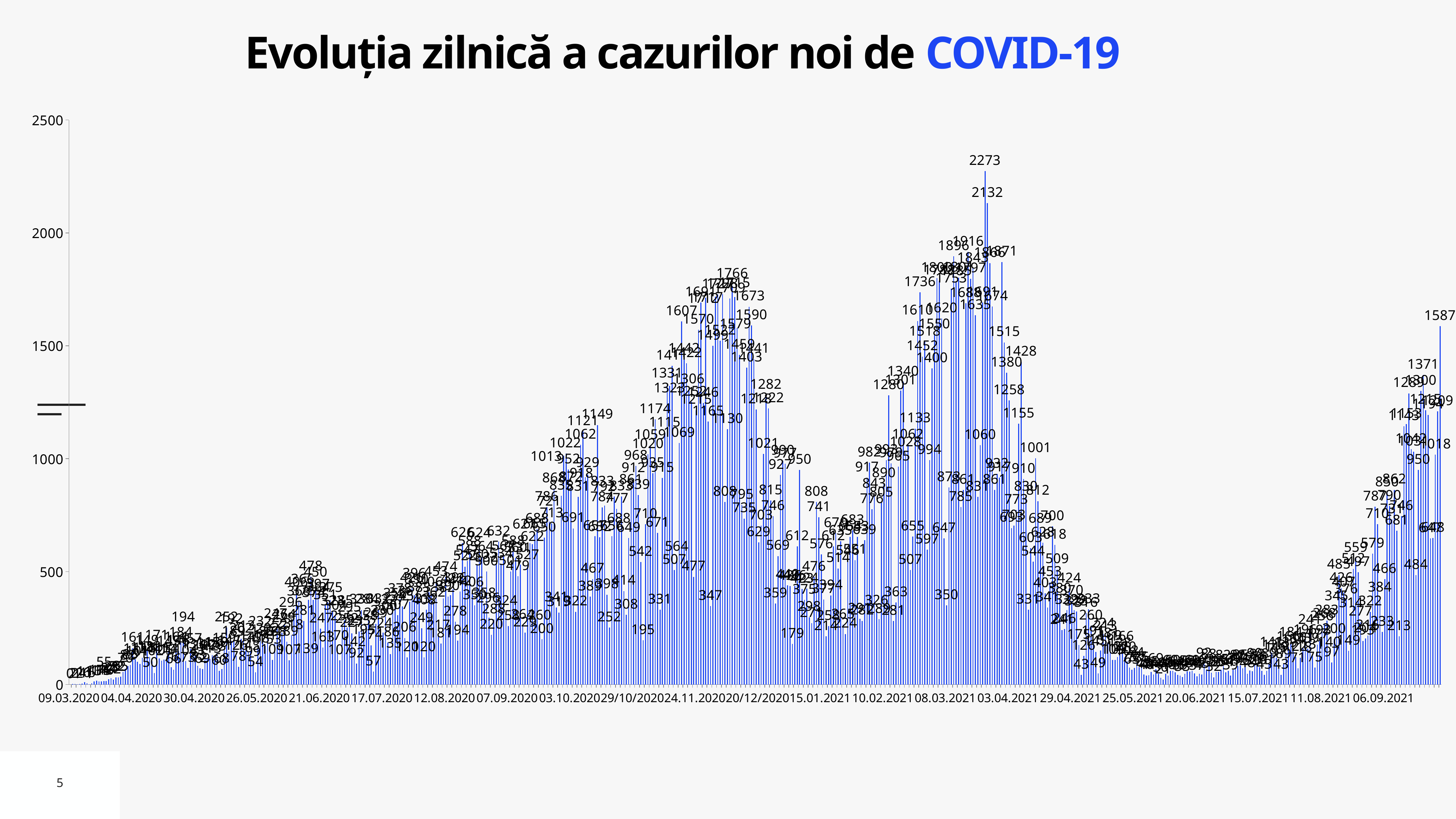
What is the difference between the peak value 2273 and the neighbouring value 2132? 141 Which is larger: the peak of the spring 2021 wave (2273) or the peak of the autumn 2020 wave (1766)? 2273 What is the highest daily value labelled on the chart? 2273 What kind of chart is shown on the slide? bar chart What is the title of the chart? Evoluția zilnică a cazurilor noi de COVID-19 What is the second-highest daily value labelled on the chart, just below the 2273 peak? 2132 Do the daily values rise or fall between 03.04.2021 and 25.05.2021? fall What is the difference between the peak value 2273 and the last bar's value 1587? 686 What is the highest value shown on the vertical axis? 2500 What value is labelled on the last (rightmost) bar of the chart? 1587 Are the daily values around 25.05.2021 greater or less than 500? less Is the highest bar on the chart greater or less than 2000? greater